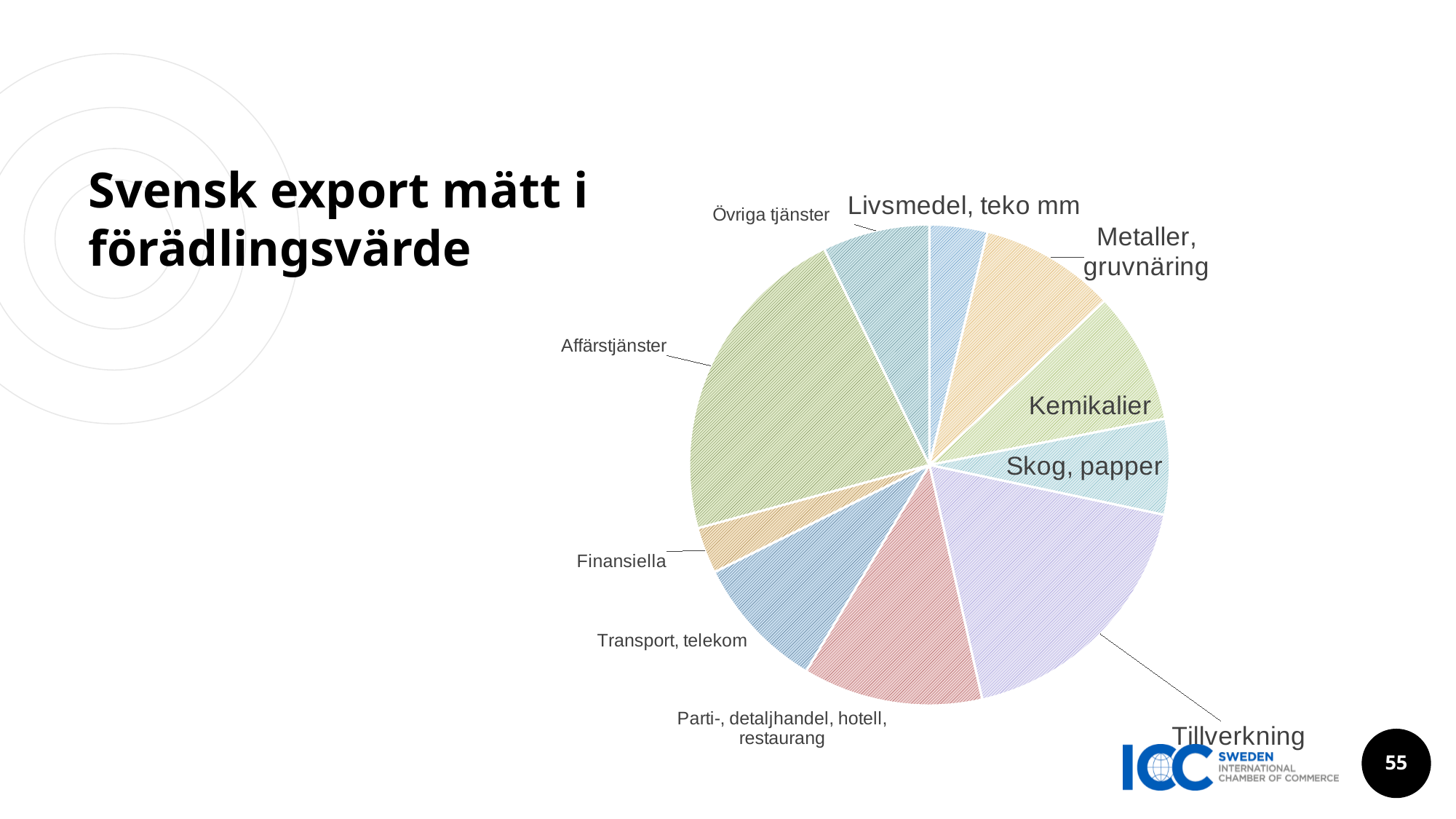
What kind of chart is shown on the slide? Pie chart Which slice is larger, Tillverkning or Livsmedel, teko mm? Tillverkning Which slice is larger, Skog, papper or Finansiella? Skog, papper What is the title of the slide containing the pie chart? Svensk export mätt i förädlingsvärde Which category has the largest slice of the pie chart? Affärstjänster Which category has the smallest slice of the pie chart? Finansiella Which slice is larger, Tillverkning or Kemikalier? Tillverkning Which category is the second-largest slice of the pie chart? Tillverkning How many slices does the pie chart have? 10